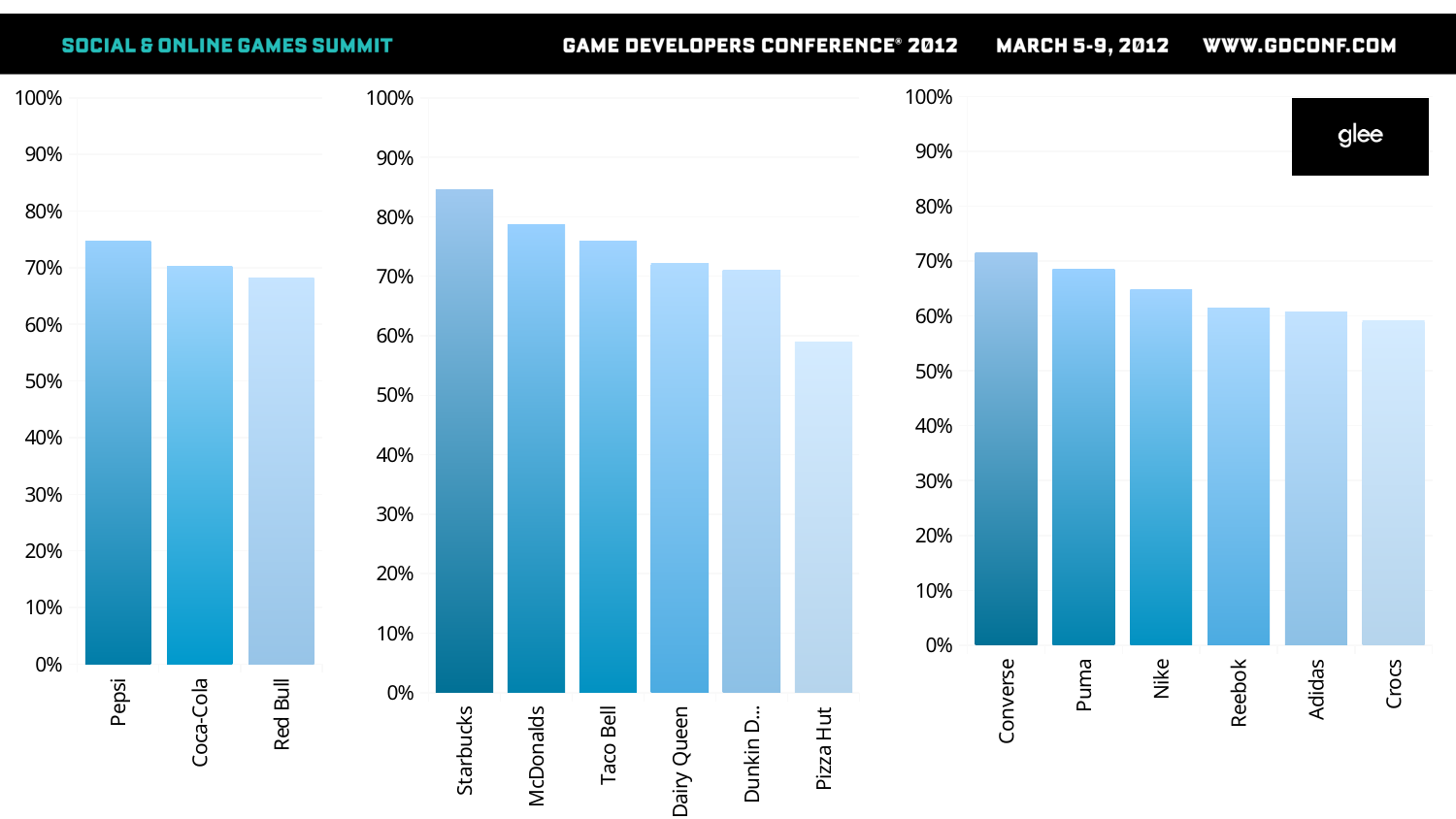
In the middle chart, do the values rise or fall from Starbucks to Pizza Hut along the x axis? fall In the left chart, which category has the highest value? Pepsi In the middle chart, which category has the lowest value? Pizza Hut How many categories are shown in the left chart (Pepsi, Coca-Cola, Red Bull)? 3 In the middle chart, which category has the highest value? Starbucks How many categories are shown in the middle chart (Starbucks to Pizza Hut)? 6 In the right chart, which category has the lowest value? Crocs What kind of chart is the left chart on the slide? bar chart How many categories are shown in the right chart (Converse to Crocs)? 6 In the middle chart, is the value for Starbucks greater or less than 80%? greater In the right chart, which category has the highest value? Converse